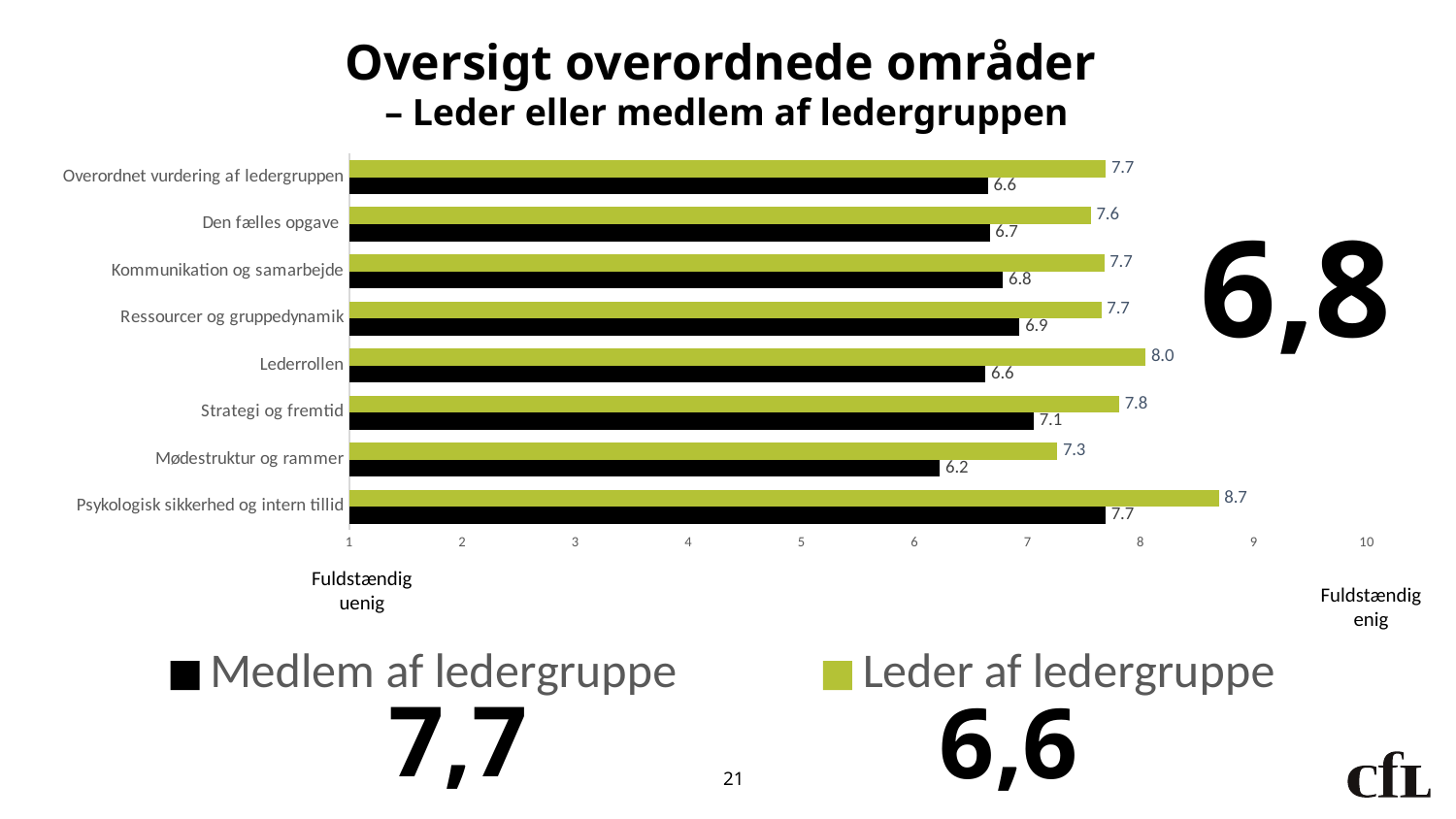
Which colour represents 'Medlem af ledergruppe' in the chart? black What is the value for 'Leder af ledergruppe' in the category 'Lederrollen'? 8.0 How many series does the legend list? 2 Is the value for 'Medlem af ledergruppe' in 'Psykologisk sikkerhed og intern tillid' greater or less than 7? greater Which category has the lowest value for 'Medlem af ledergruppe'? Mødestruktur og rammer Which is larger for 'Den fælles opgave': the value for 'Leder af ledergruppe' or for 'Medlem af ledergruppe'? Leder af ledergruppe How many categories are shown on the chart? 8 What is the value for 'Medlem af ledergruppe' in the category 'Strategi og fremtid'? 7.1 What kind of chart is shown on the slide? bar chart Which category has the highest value for 'Leder af ledergruppe'? Psykologisk sikkerhed og intern tillid What is the difference between the 'Leder af ledergruppe' and 'Medlem af ledergruppe' values for 'Lederrollen'? 1.4 What is the value for 'Medlem af ledergruppe' in the category 'Mødestruktur og rammer'? 6.2